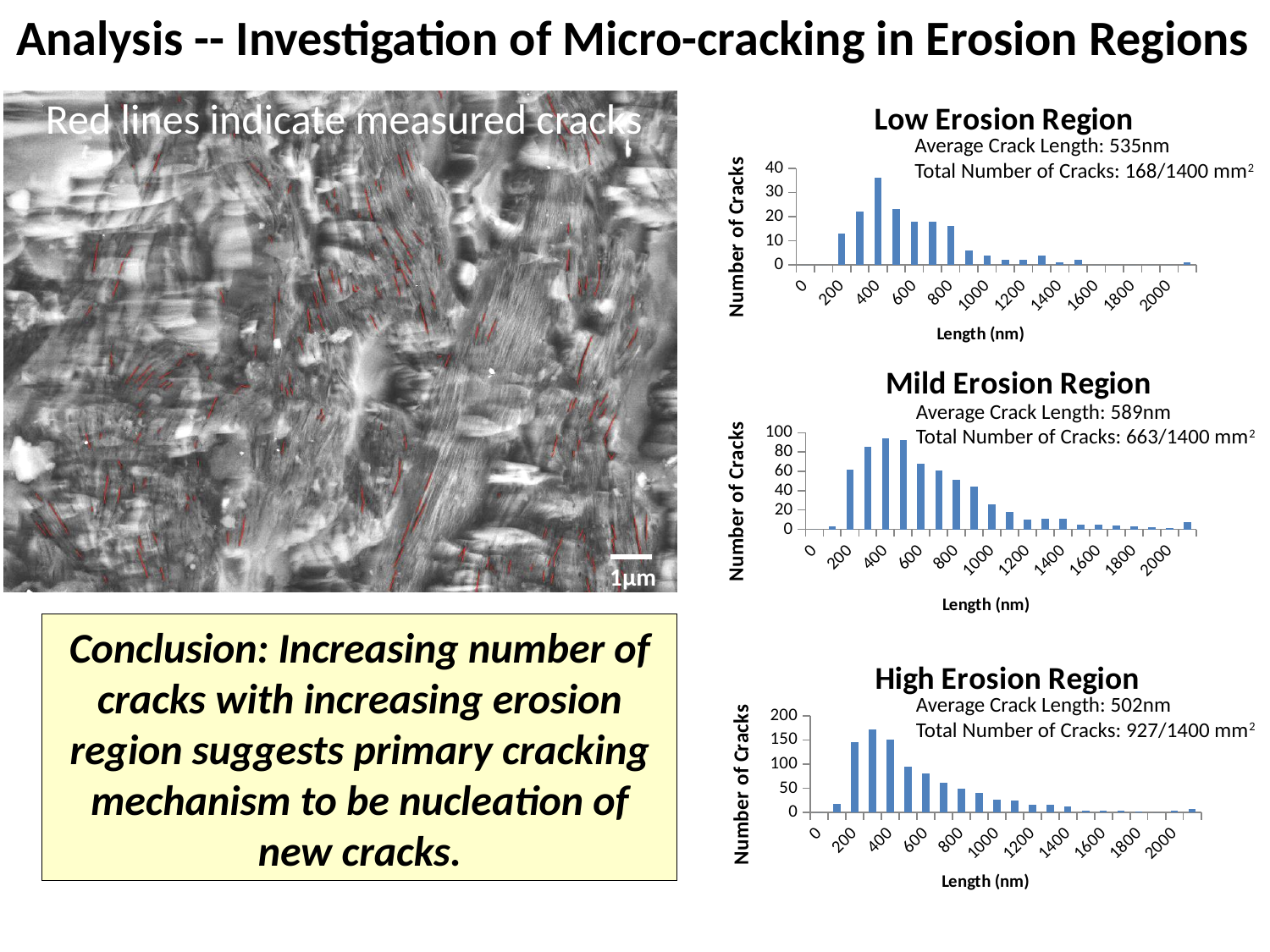
In the High Erosion Region chart, which has more cracks: the 200 nm bin or the 600 nm bin? 200 nm In the Low Erosion Region chart, is the number of cracks at 400 nm greater or less than 30? greater In the Mild Erosion Region chart, is the number of cracks at 200 nm greater or less than 40? greater In the Low Erosion Region chart, which length bin has the highest number of cracks? 400 In the Mild Erosion Region chart, is the number of cracks at 1000 nm greater or less than 40? less In the Low Erosion Region chart, which has more cracks: the 400 nm bin or the 600 nm bin? 400 nm In the High Erosion Region chart, which length bin has the highest number of cracks? 300 What is the x-axis label on the Mild Erosion Region chart? Length (nm) In the High Erosion Region chart, do the number of cracks rise or fall as length increases beyond 300 nm? fall What kind of chart is the Low Erosion Region chart? bar chart